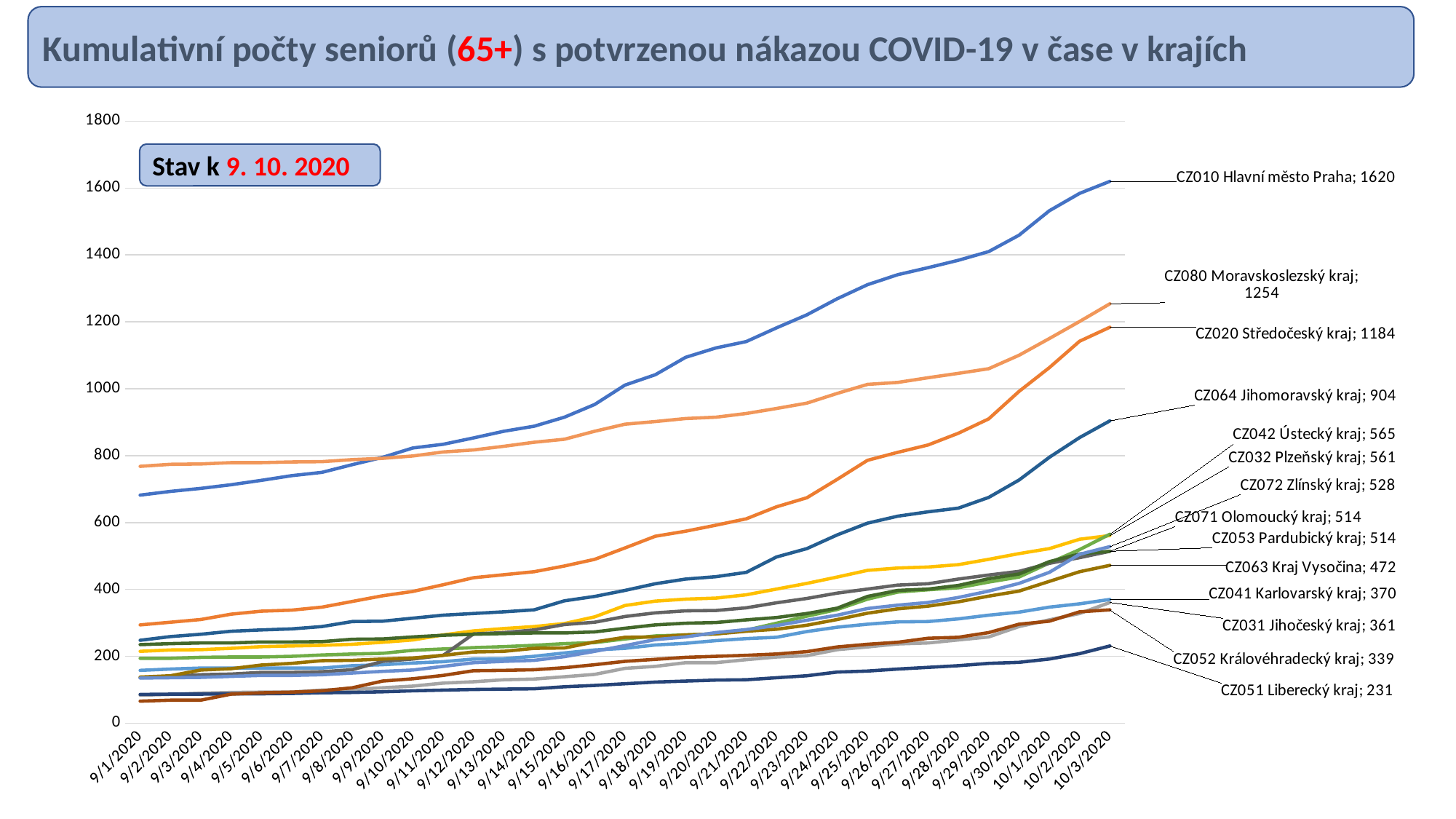
Does the line for CZ010 Hlavní město Praha rise or fall from 9/1/2020 to 10/3/2020? rise What is the difference between the final labelled values of CZ080 Moravskoslezský kraj and CZ020 Středočeský kraj? 70 Is the value for CZ010 Hlavní město Praha on 9/1/2020 greater or less than 800? less How many regions (series) are labelled on the chart? 14 What type of chart is shown on the slide? line chart What is the final labelled value for CZ064 Jihomoravský kraj? 904 Which region has the highest final labelled value? CZ010 Hlavní město Praha Which region has the lowest final labelled value? CZ051 Liberecký kraj What is the final labelled value for CZ051 Liberecký kraj? 231 Which has a larger final labelled value, CZ041 Karlovarský kraj or CZ031 Jihočeský kraj? CZ041 Karlovarský kraj What is the final labelled value for CZ080 Moravskoslezský kraj? 1254 What is the final labelled value for CZ010 Hlavní město Praha? 1620